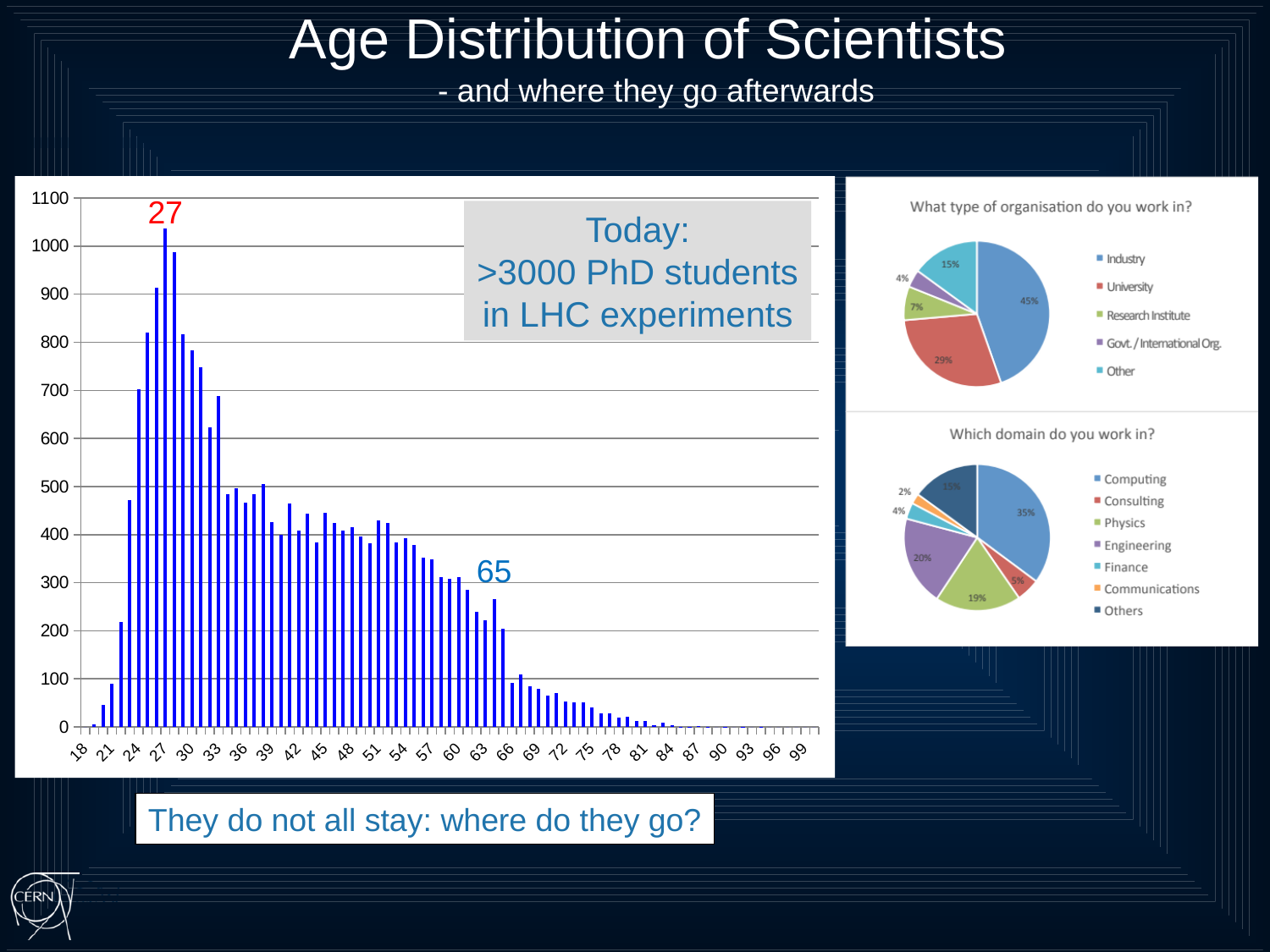
In the age distribution bar chart, is the value for age 75 greater or less than 100? less What kind of chart is the age distribution chart on the left of the slide? bar chart How many categories does the legend of the pie chart 'What type of organisation do you work in?' list? 5 In the pie chart 'What type of organisation do you work in?', what share is Industry? 45% How many categories does the legend of the pie chart 'Which domain do you work in?' list? 7 In the age distribution bar chart, is the value for age 27 greater or less than 1000? greater In the age distribution bar chart, which age has the highest number of scientists? 27 In the pie chart 'What type of organisation do you work in?', which category has the largest share? Industry In the pie chart 'Which domain do you work in?', what share is Computing? 35% In the age distribution bar chart, is the value for age 24 greater or less than 600? greater In the pie chart 'Which domain do you work in?', which category has the smallest share? Communications In the pie chart 'What type of organisation do you work in?', what share is University? 29%